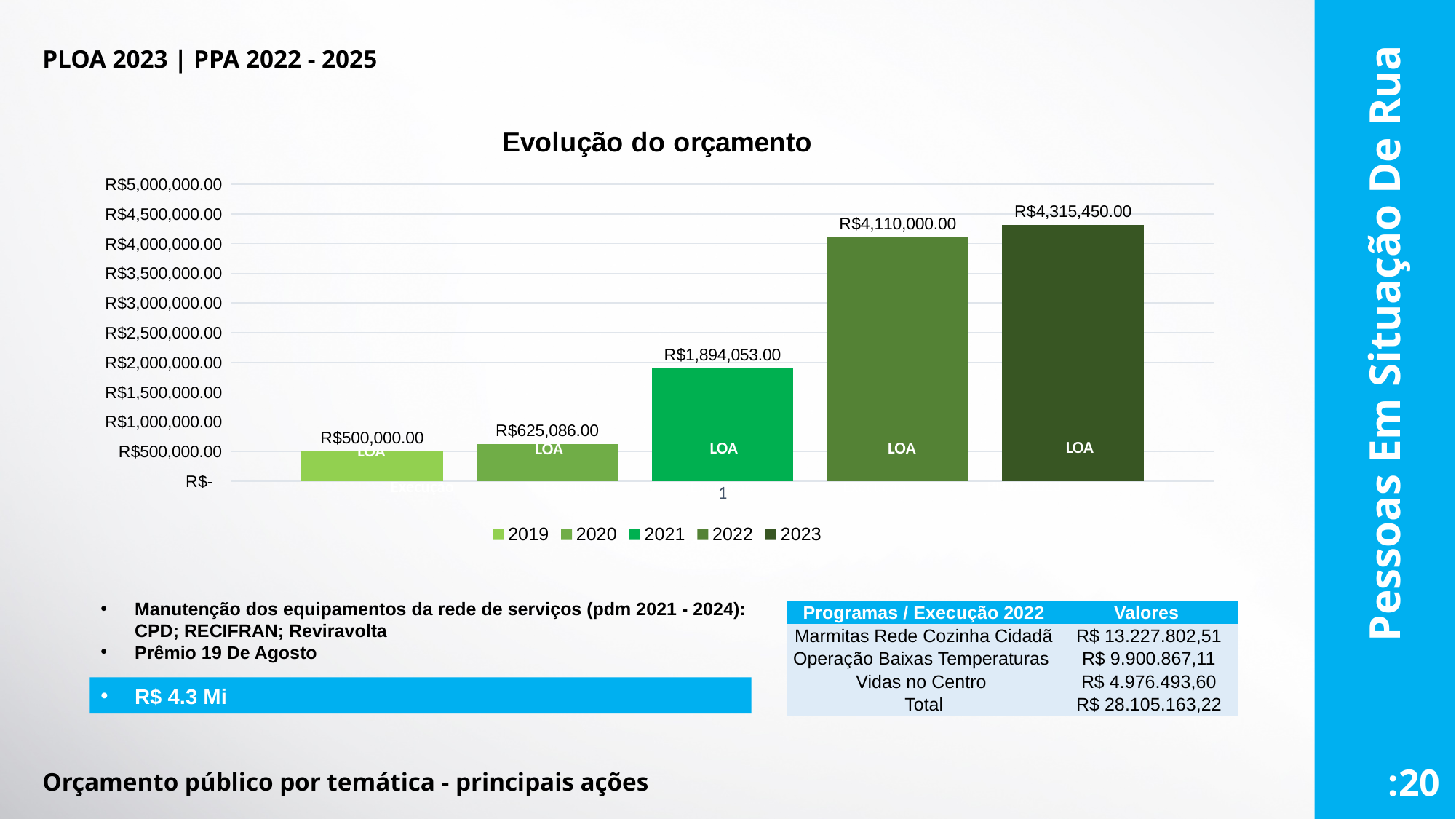
What is the value shown for 2021? R$1,894,053.00 Which year has the lowest value in the chart? 2019 How many series does the chart legend list? 5 What type of chart is shown on the slide? bar chart What is the title of the chart? Evolução do orçamento What is the difference between the values for 2023 and 2022? R$205,450.00 What is the value shown for 2019? R$500,000.00 Which is larger, the value for 2021 or the value for 2022? 2022 What is the difference between the values for 2020 and 2019? R$125,086.00 Which year has the highest value in the chart? 2023 What is the value shown for 2023? R$4,315,450.00 Do the values rise or fall from 2019 to 2023? rise